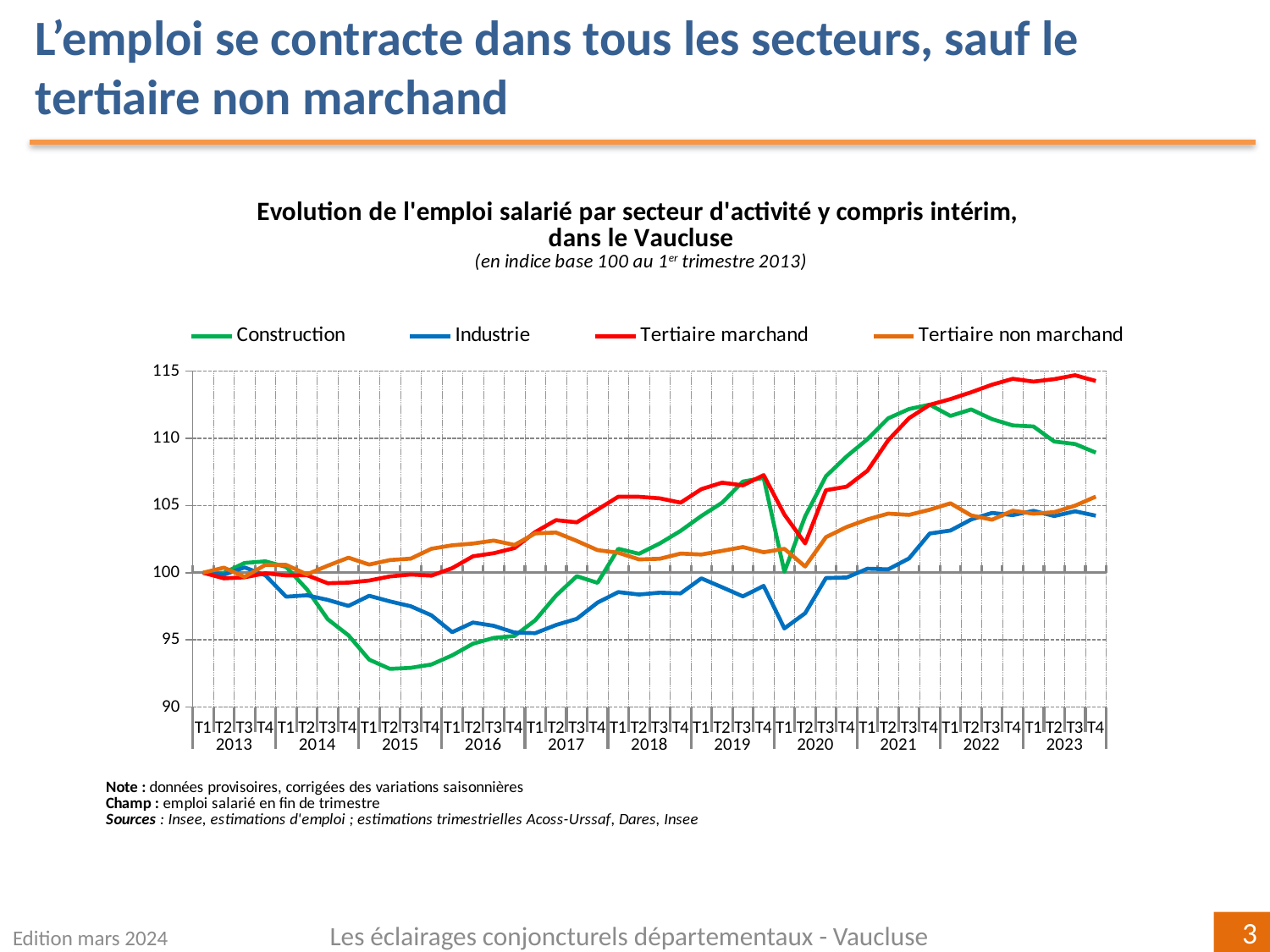
At T2 2015, which is larger: Construction or Industrie? Industrie How many series does the legend list? 4 Is the value for Industrie at T1 2020 greater or less than 100? less What kind of chart is shown on the slide? line chart How many years are shown on the x axis? 11 Which series has the lowest value at T2 2015? Construction Is the value for Construction at T4 2023 greater or less than 105? greater Is the value for Tertiaire marchand at T4 2023 greater or less than 110? greater Does the Construction series rise or fall between T1 2022 and T4 2023? fall Which series has the highest value at T4 2023? Tertiaire marchand What is the index value of all series at T1 2013? 100